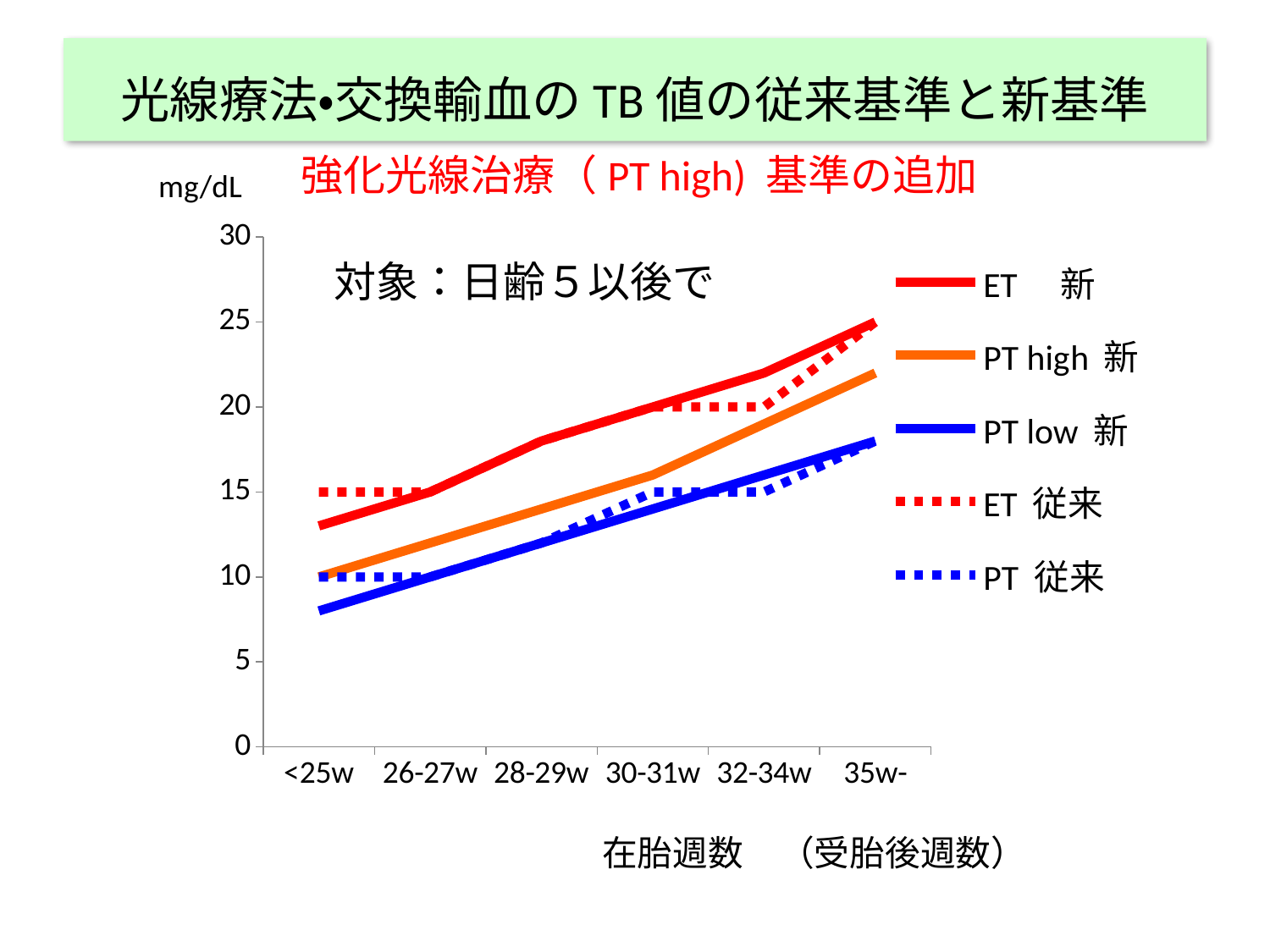
What is the value of the PT high 新 line at <25w? 10 Is the value of the PT high 新 line at 35w- greater or less than 20? greater How many series does the legend list? 5 What is the value of the ET 新 line at 30-31w? 20 Which series has the highest value at 35w-? ET 新 and ET 従来 (tied at 25) Which series has the lowest value at <25w? PT low 新 How many gestational-week categories are shown on the x axis? 6 Is the value of the PT low 新 line at <25w greater or less than 10? less Do the values of the ET 新 line rise or fall as gestational weeks increase along the x axis? rise What is the value of the ET 新 line at 35w-? 25 What kind of chart is shown on the slide? line chart